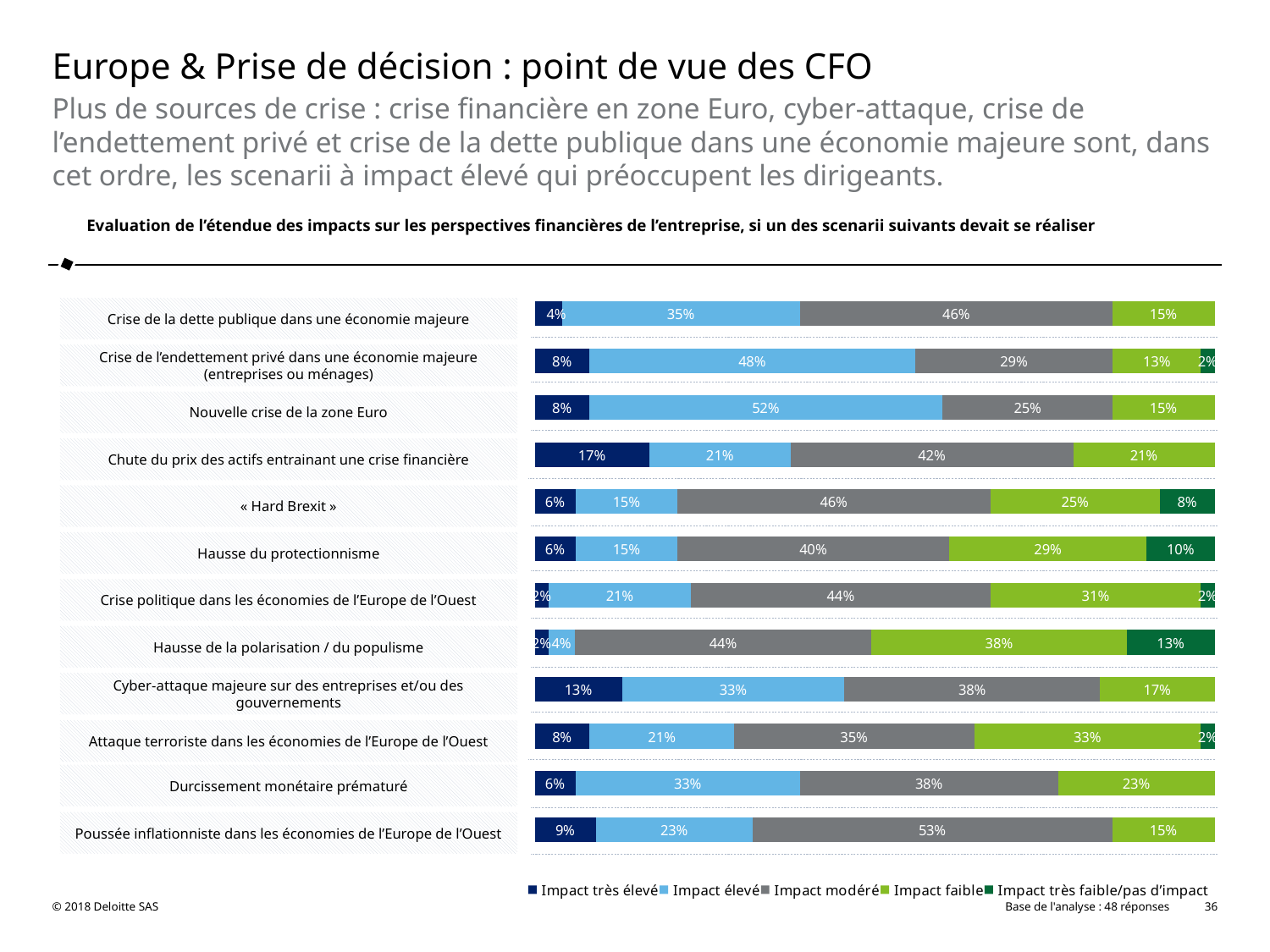
What is the total of the stacked bar for 'Crise de la dette publique dans une économie majeure'? 100% How many series does the legend list? 5 Which scenario has the highest 'Impact très élevé' value? Chute du prix des actifs entrainant une crise financière What is the difference between the 'Impact élevé' values for 'Nouvelle crise de la zone Euro' and 'Crise de la dette publique dans une économie majeure'? 17% What type of chart is shown on the slide? Stacked bar chart Which is larger: the 'Impact faible' value for 'Hausse de la polarisation / du populisme' or for '« Hard Brexit »'? Hausse de la polarisation / du populisme What is the last entry in the chart's legend? Impact très faible/pas d'impact What is the 'Impact très élevé' value for 'Cyber-attaque majeure sur des entreprises et/ou des gouvernements'? 13% How many scenarios (categories) are plotted in the chart? 12 What is the 'Impact élevé' value for 'Nouvelle crise de la zone Euro'? 52% What is the 'Impact modéré' value for 'Poussée inflationniste dans les économies de l'Europe de l'Ouest'? 53% Which scenario has the highest 'Impact élevé' value? Nouvelle crise de la zone Euro